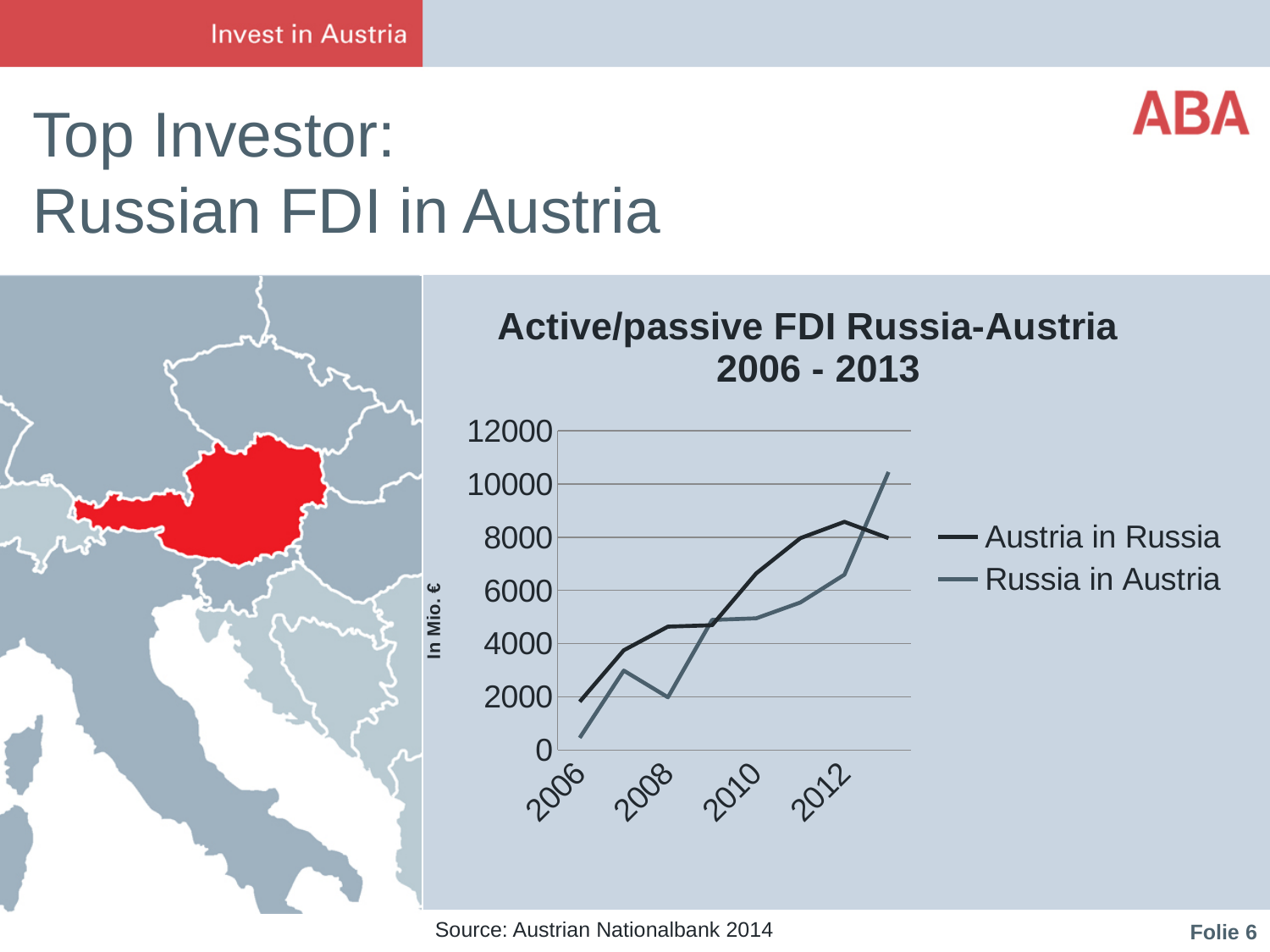
Is the value for Russia in Austria in 2006 greater or less than 2000? less Which series has the higher value in 2010, Austria in Russia or Russia in Austria? Austria in Russia Which series has the higher value in 2013, Austria in Russia or Russia in Austria? Russia in Austria Does the Russia in Austria series overall rise or fall from 2006 to 2013? rise How many series does the legend list? 2 Is the value for Austria in Russia in 2012 greater or less than 8000? greater In which year does the Russia in Austria series reach its highest value? 2013 What unit is shown on the vertical axis label? In Mio. € Is the value for Russia in Austria in 2012 greater or less than 6000? greater What is the title of the chart? Active/passive FDI Russia-Austria 2006 - 2013 What kind of chart is shown on the slide? line chart